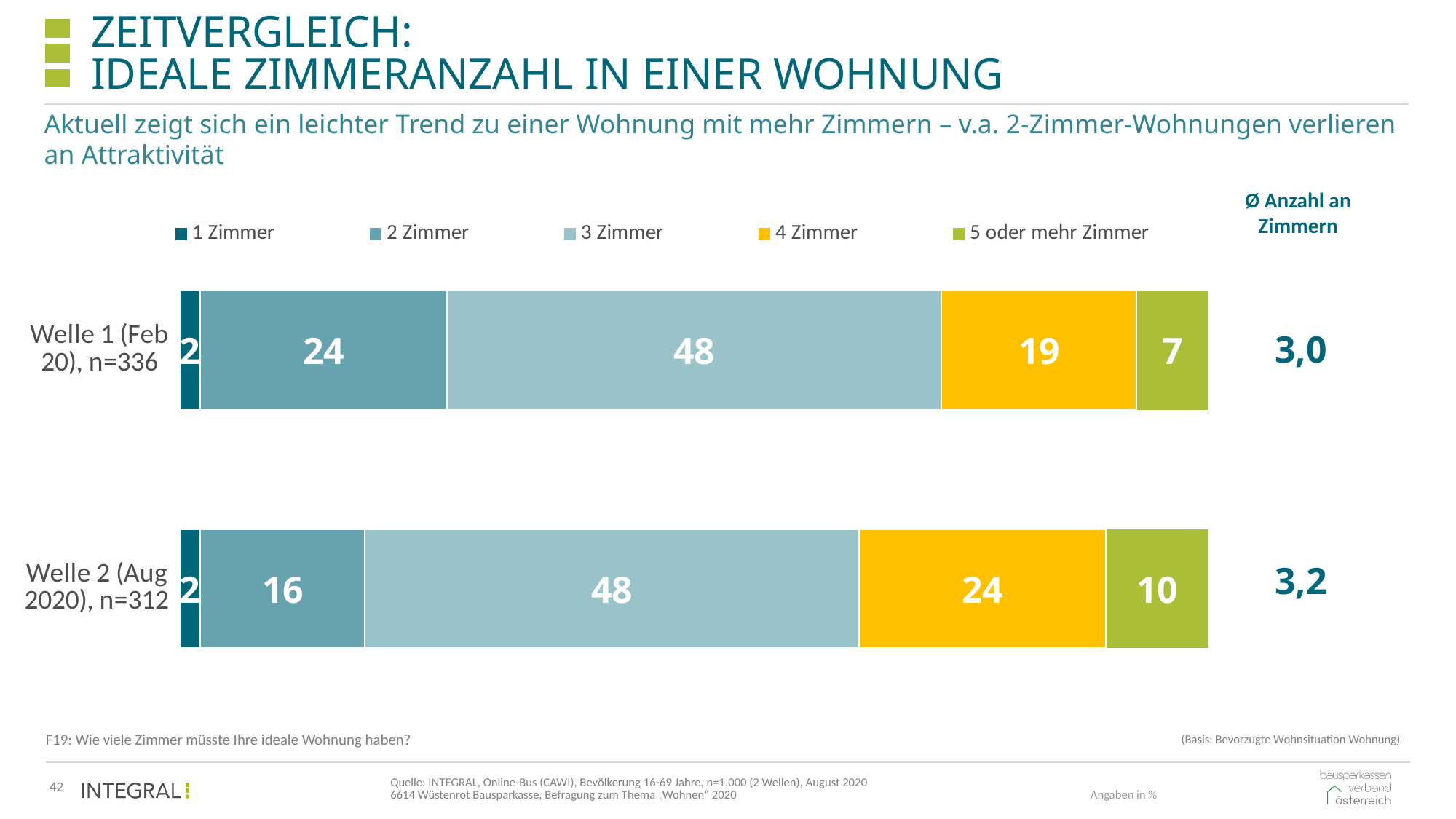
What kind of chart is shown on the slide? stacked bar chart What is the total of the stacked bar for Welle 2 (Aug 2020)? 100 Which category has the highest value in Welle 2 (Aug 2020)? 3 Zimmer What is the average number of rooms (Ø Anzahl an Zimmern) shown for Welle 2 (Aug 2020)? 3,2 Which is larger: the 4 Zimmer value in Welle 1 or in Welle 2? Welle 2 What is the value for 4 Zimmer in Welle 2 (Aug 2020)? 24 What is the value for 5 oder mehr Zimmer in Welle 1 (Feb 20)? 7 What is the value for 2 Zimmer in Welle 1 (Feb 20)? 24 How many series does the legend list? 5 Which category has the lowest value in Welle 1 (Feb 20)? 1 Zimmer How many bars (waves) are plotted in the chart? 2 What is the difference between the 2 Zimmer values of Welle 1 and Welle 2? 8